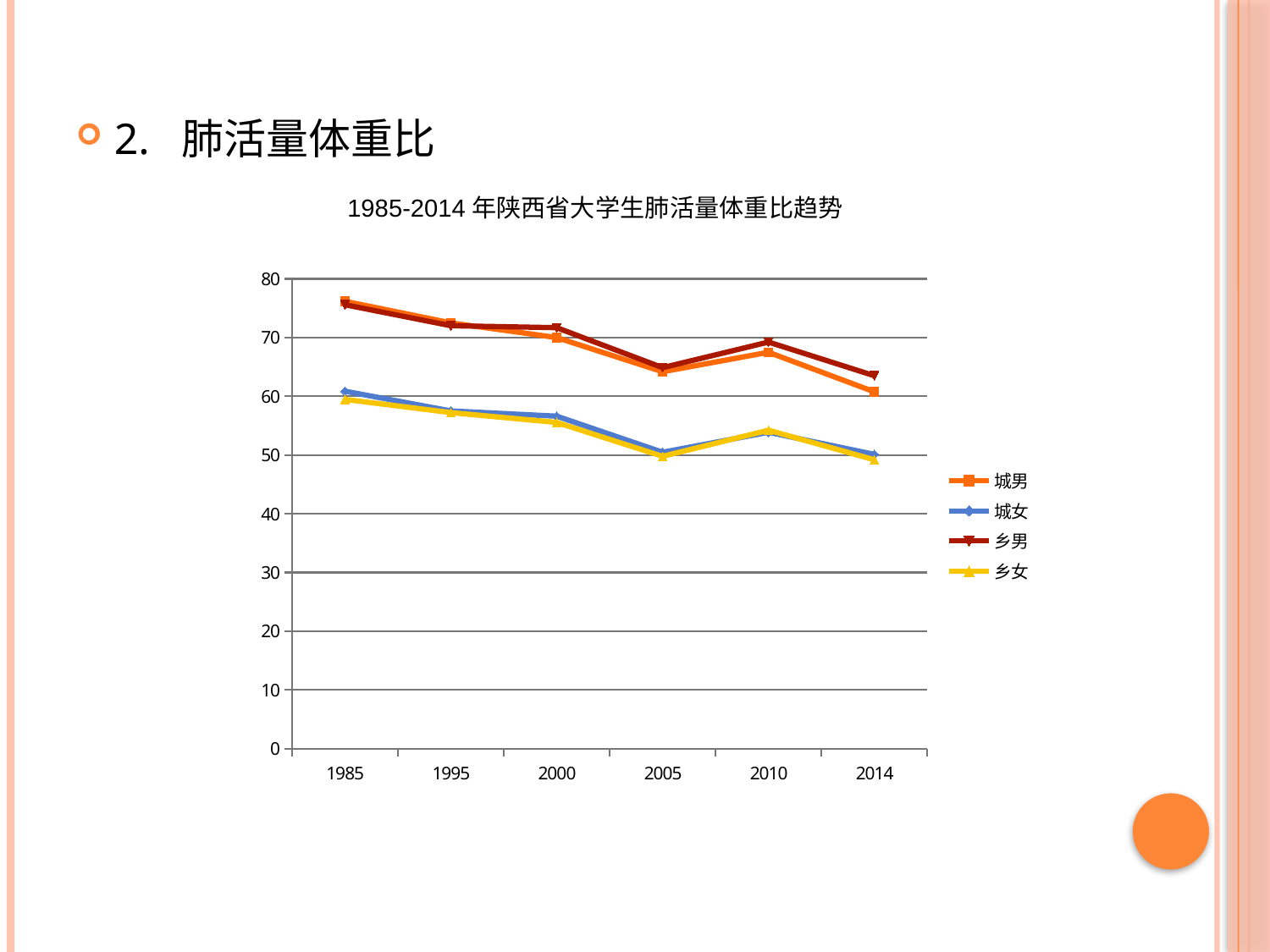
Is the value for 乡男 in 2005 greater or less than 70? less How many years are plotted along the x axis? 6 How many series does the legend list? 4 In 1985, which is larger, the value for 城男 or the value for 城女? 城男 In which year is the value for 城男 highest? 1985 What is the title of the chart? 1985-2014 年陕西省大学生肺活量体重比趋势 Which series has the highest value in 2014? 乡男 Is the value for 城女 in 2010 greater or less than 50? greater Is the value for 城男 in 1985 greater or less than 70? greater What kind of chart is shown on the slide? line chart Overall, do the values for 城男 rise or fall from 1985 to 2014? fall Which series is drawn in yellow? 乡女